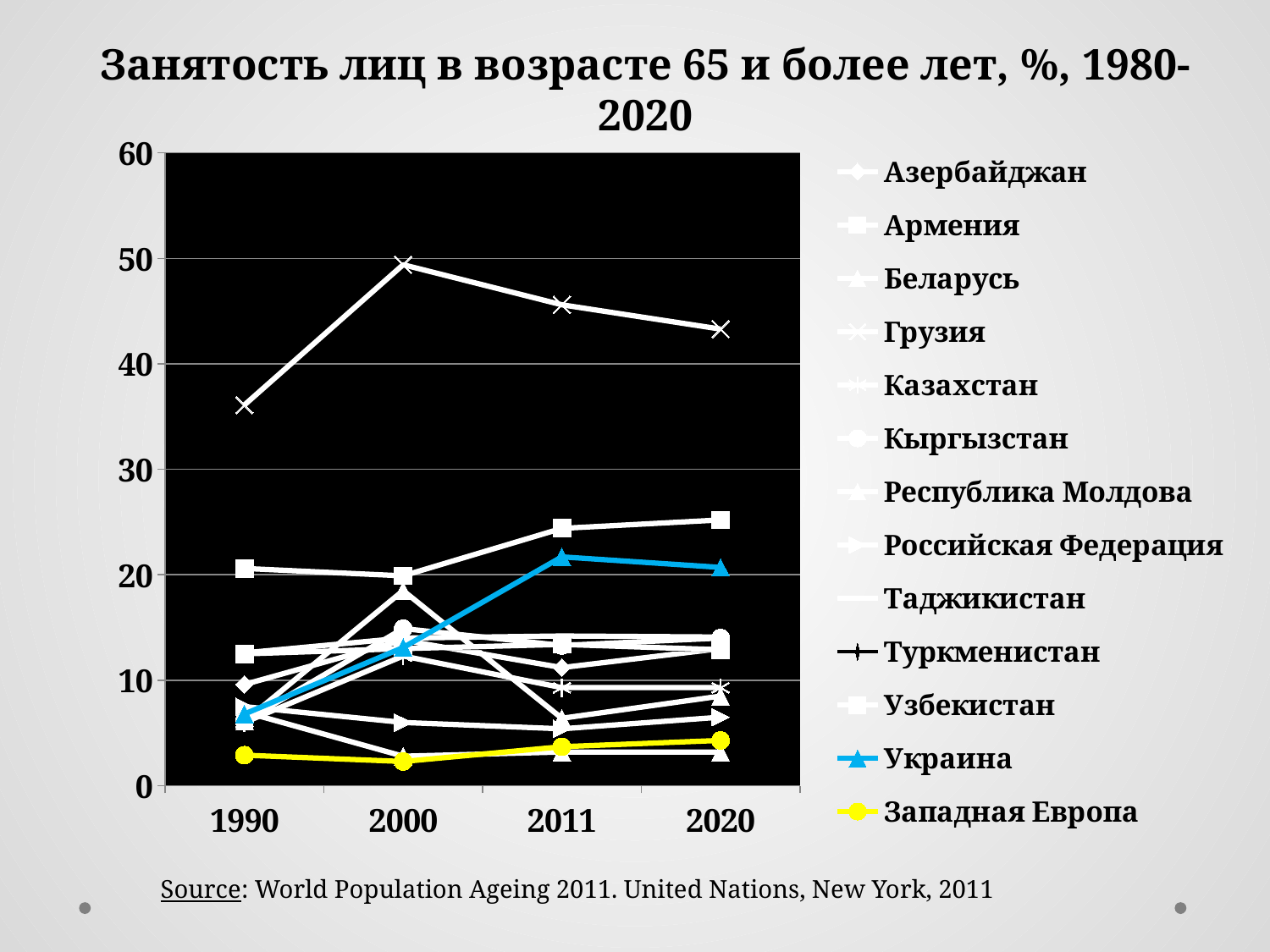
Is the value for Западная Европа in 2020 greater or less than 10? less Which is larger in 2020, the value for Грузия or the value for Украина? Грузия Is the value for Украина in 1990 greater or less than 10? less Does the value for Грузия rise or fall from 2000 to 2020? fall Which series has the highest value in 2000? Грузия What kind of chart is shown on the slide? line chart How many years are plotted along the x axis? 4 Is the value for Грузия in 2000 greater or less than 40? greater How many series does the legend list? 13 What is the title of the chart? Занятость лиц в возрасте 65 и более лет, %, 1980-2020 Which series is drawn in yellow? Западная Европа